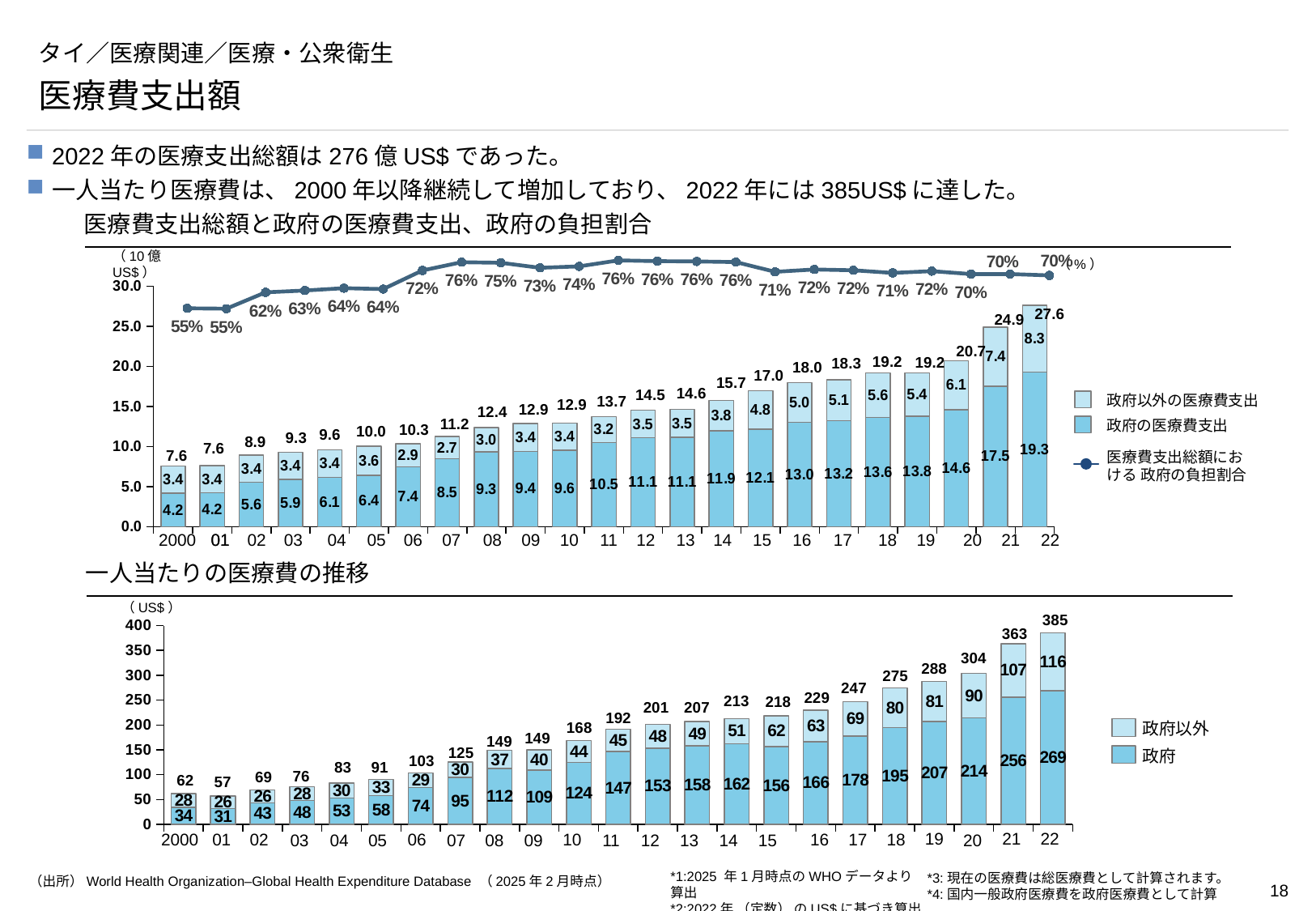
In the bottom chart, what is the government (政府) per-capita value for 2019? 207 In the bottom chart (一人当たりの医療費の推移), what is the per-capita health expenditure total for 2022? 385 In the top chart, what is the government share (政府の負担割合) shown for 2007? 76% In the bottom chart, is the per-capita total for 2021 larger or smaller than for 2020? larger In the top chart, which year has the lowest government share on the line? 2000 and 2001 (55%) In the top chart, what is the government health expenditure (政府の医療費支出) for 2021? 17.5 In the bottom chart, what is the difference between the non-government (政府以外) values for 2022 and 2021? 9 In the top chart, how many series does the legend list? 3 In the top chart (医療費支出総額と政府の医療費支出、政府の負担割合), what is the total health expenditure for 2022? 27.6 What kind of chart is the bottom chart (一人当たりの医療費の推移)? Stacked bar chart In the top chart, what is the difference between the total health expenditure in 2022 and in 2021? 2.7 In the bottom chart, which year has the lowest per-capita total? 2001